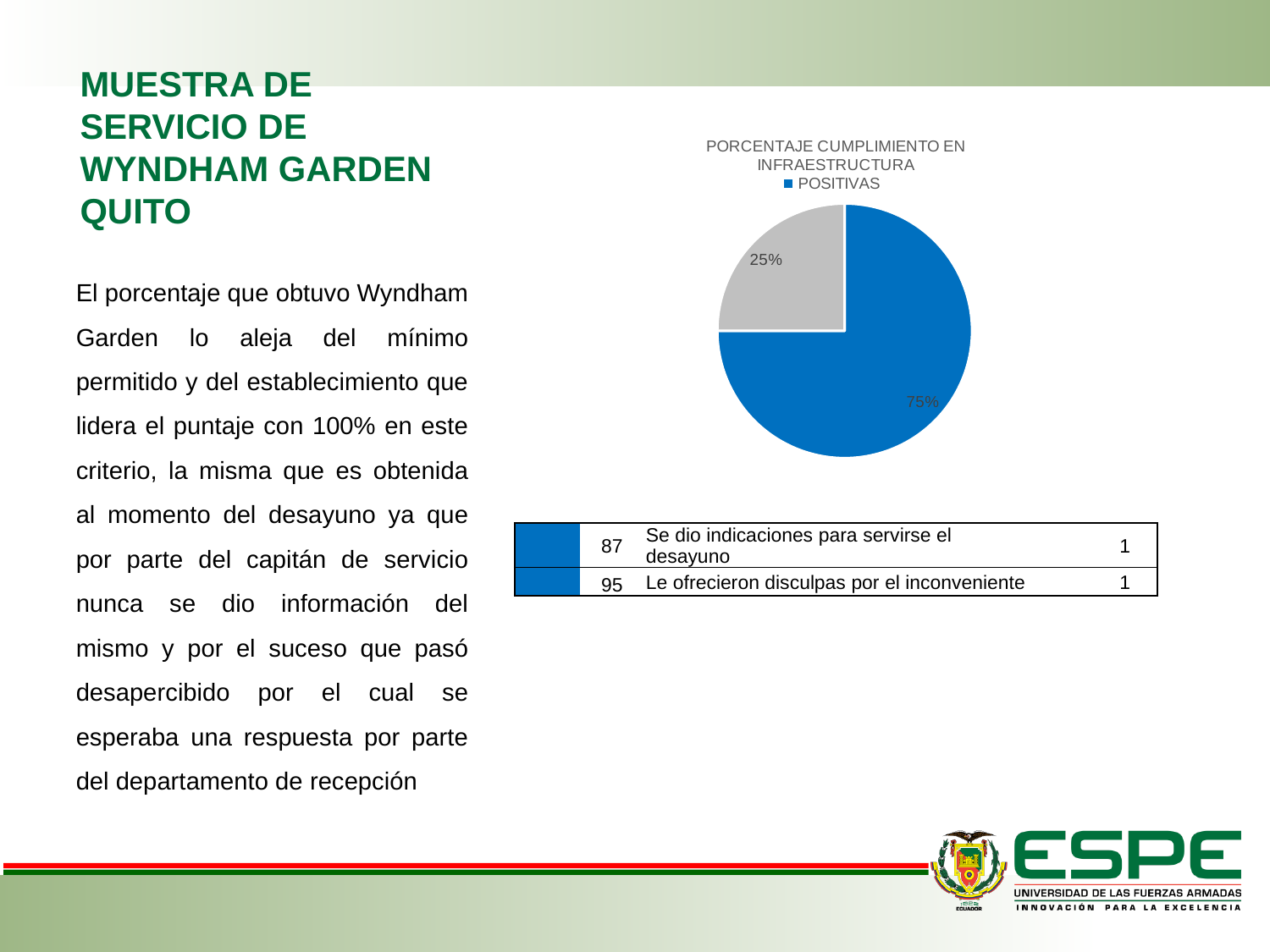
What is the difference in percentage points between the two slices of the pie chart? 50 What is the title of the chart? PORCENTAJE CUMPLIMIENTO EN INFRAESTRUCTURA What type of chart is shown on the slide? pie chart What is the share of the smallest slice in the pie chart? 25% What percentage is shown for the POSITIVAS slice of the pie? 75% Is the value for POSITIVAS greater or less than 50%? greater What is the share of the largest slice in the pie chart? 75% How many entries does the chart legend list? 1 Is the POSITIVAS slice larger or smaller than the other slice? larger How many slices does the pie chart have? 2 What is the name of the series listed in the chart legend? POSITIVAS